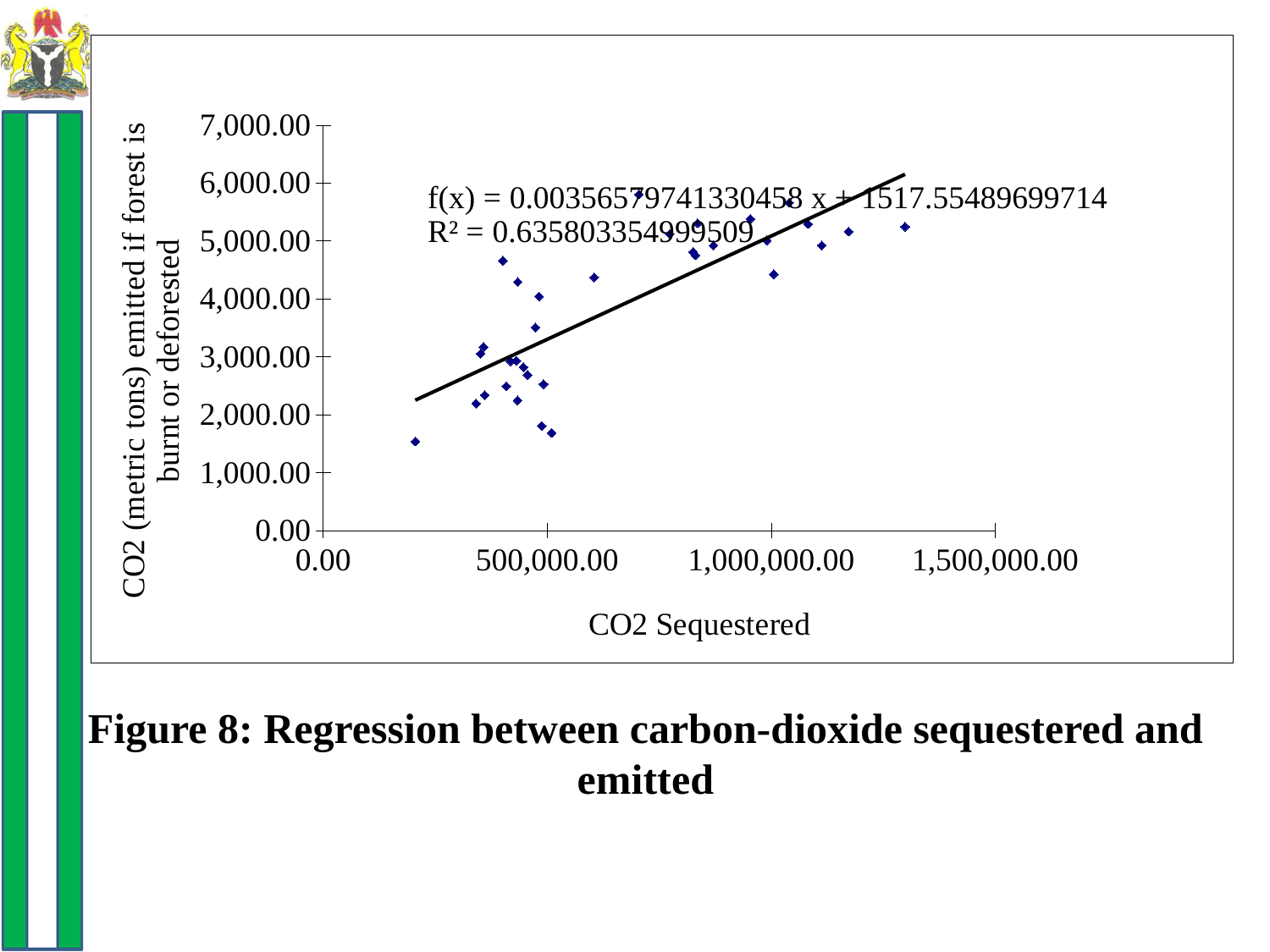
What is the highest tick value shown on the x axis? 1,500,000.00 What is the title of the y axis? CO2 (metric tons) emitted if forest is burnt or deforested Is the y value of the lowest plotted point greater or less than 2,000.00? less Is the x value of the leftmost plotted point greater or less than 500,000.00? less What is the highest tick value shown on the y axis? 7,000.00 What is the intercept in the trendline equation printed on the chart? 1517.55489699714 What is the slope (coefficient of x) in the trendline equation printed on the chart? 0.00356579741330458 Is the y value of the highest plotted point greater or less than 5,000.00? greater Do the plotted values generally rise or fall as CO2 Sequestered increases along the x axis? rise What kind of chart is shown on the slide? scatter plot What R² value is printed on the chart? 0.635803354999509 What is the title of the x axis? CO2 Sequestered